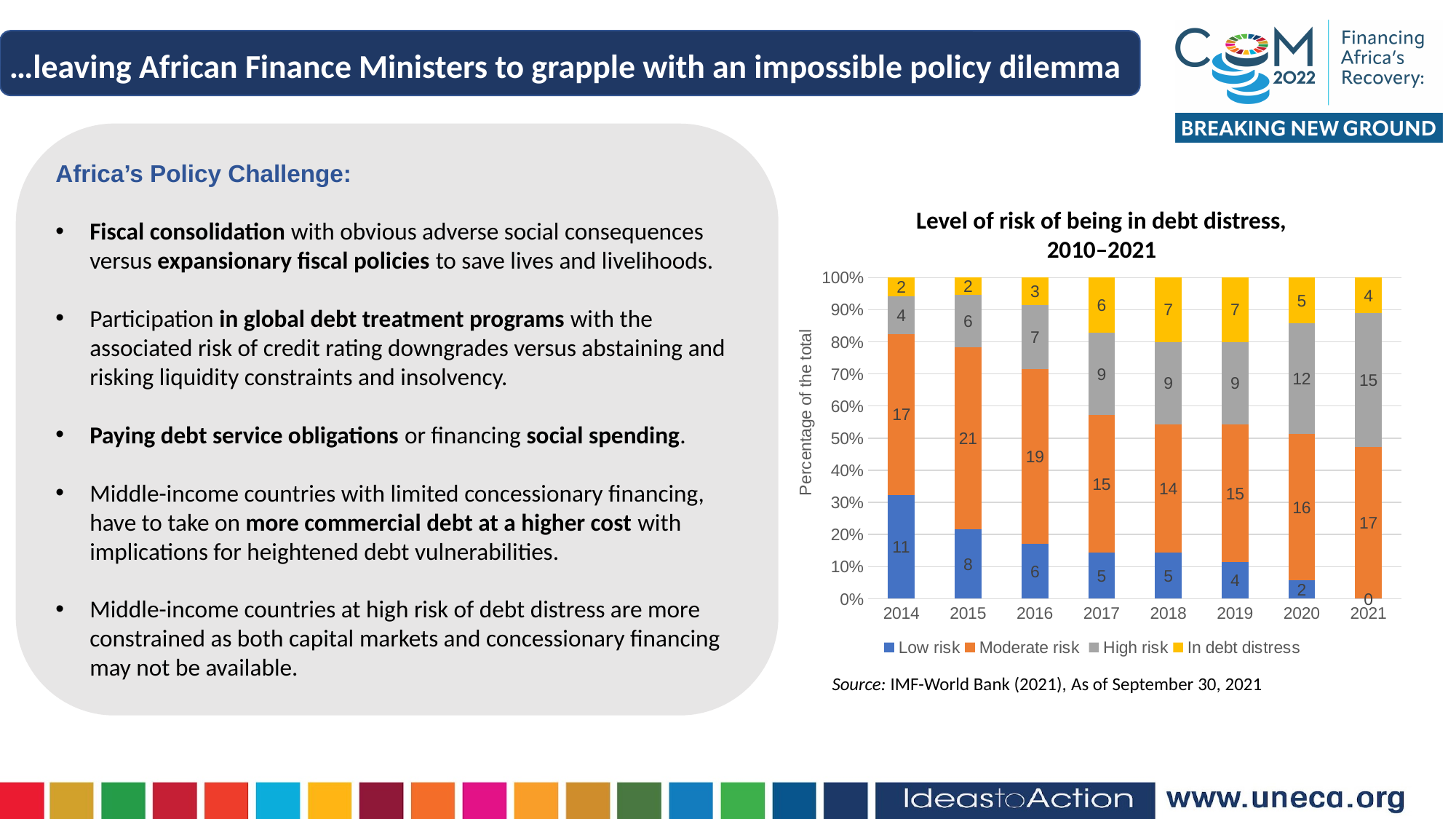
In which year is the Low risk count lowest? 2021 What is the number of countries In debt distress in 2018? 7 What is the number of countries at Low risk in 2014? 11 What is the difference between the Moderate risk count in 2015 and in 2018? 7 In which year is the Low risk count highest? 2014 How many years are shown on the x axis of the chart? 8 Which is larger: the High risk count in 2020 or the High risk count in 2016? 2020 How does the Low risk count change from 2014 to 2021? It falls What type of chart is shown on the slide? stacked bar chart What is the total number of countries across all four risk categories in 2014? 34 What is the number of countries at High risk in 2021? 15 How many series does the legend list? 4